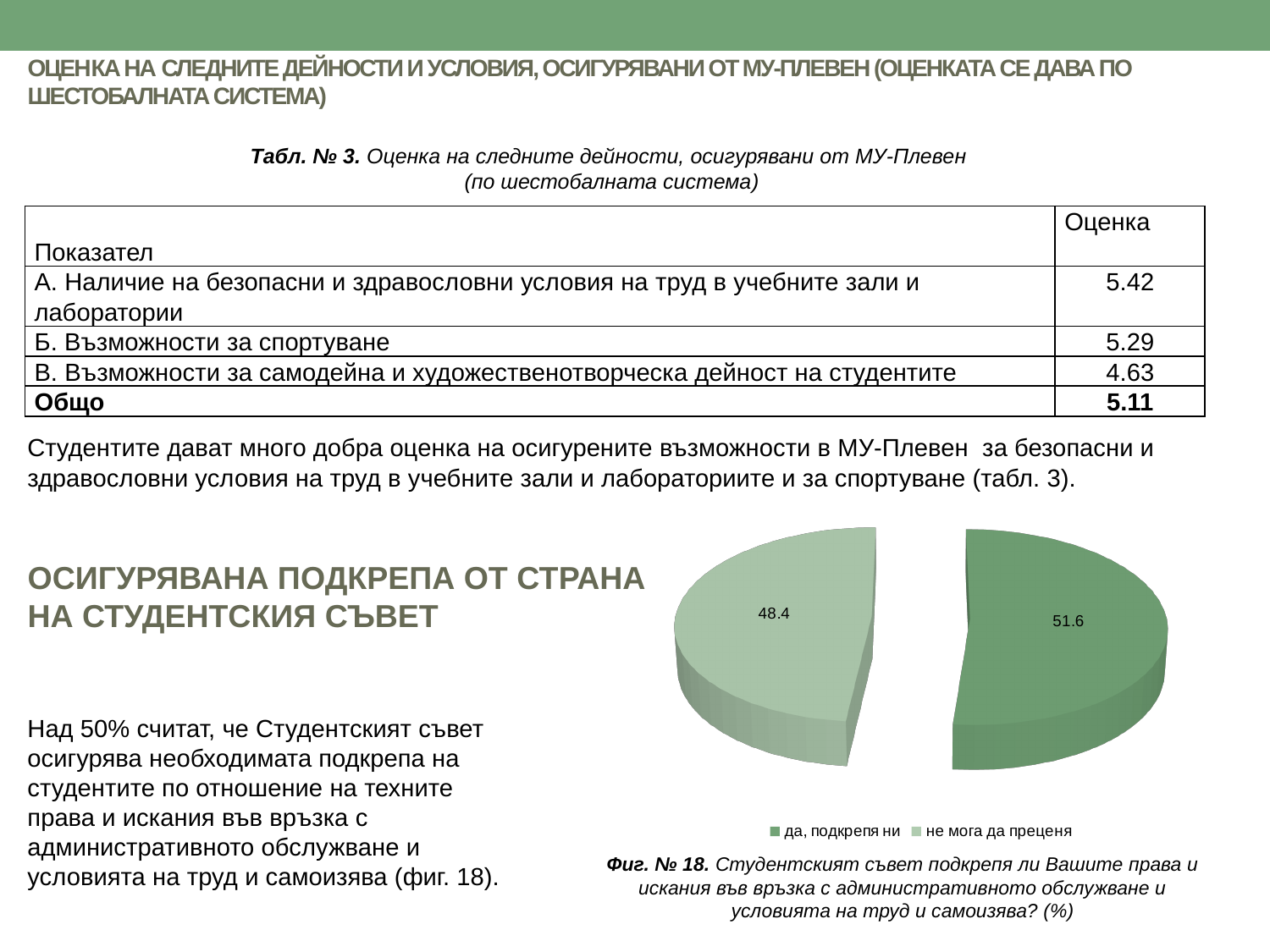
Which slice of the pie chart is the largest? да, подкрепя ни In the pie chart, what is the value shown for the slice "да, подкрепя ни"? 51.6 How many slices does the pie chart have? 2 What figure number is given in the caption of the pie chart? Фиг. № 18 How many entries does the legend of the pie chart list? 2 In the pie chart, which is larger: "да, подкрепя ни" or "не мога да преценя"? да, подкрепя ни In the pie chart, what is the value shown for the slice "не мога да преценя"? 48.4 Which slice of the pie chart is the smallest? не мога да преценя In the pie chart, what is the difference between the values for "да, подкрепя ни" and "не мога да преценя"? 3.2 What colour is the "да, подкрепя ни" slice in the pie chart? Dark green What kind of chart is shown on the slide? Pie chart In the pie chart, is the value for "да, подкрепя ни" greater or less than 50? greater